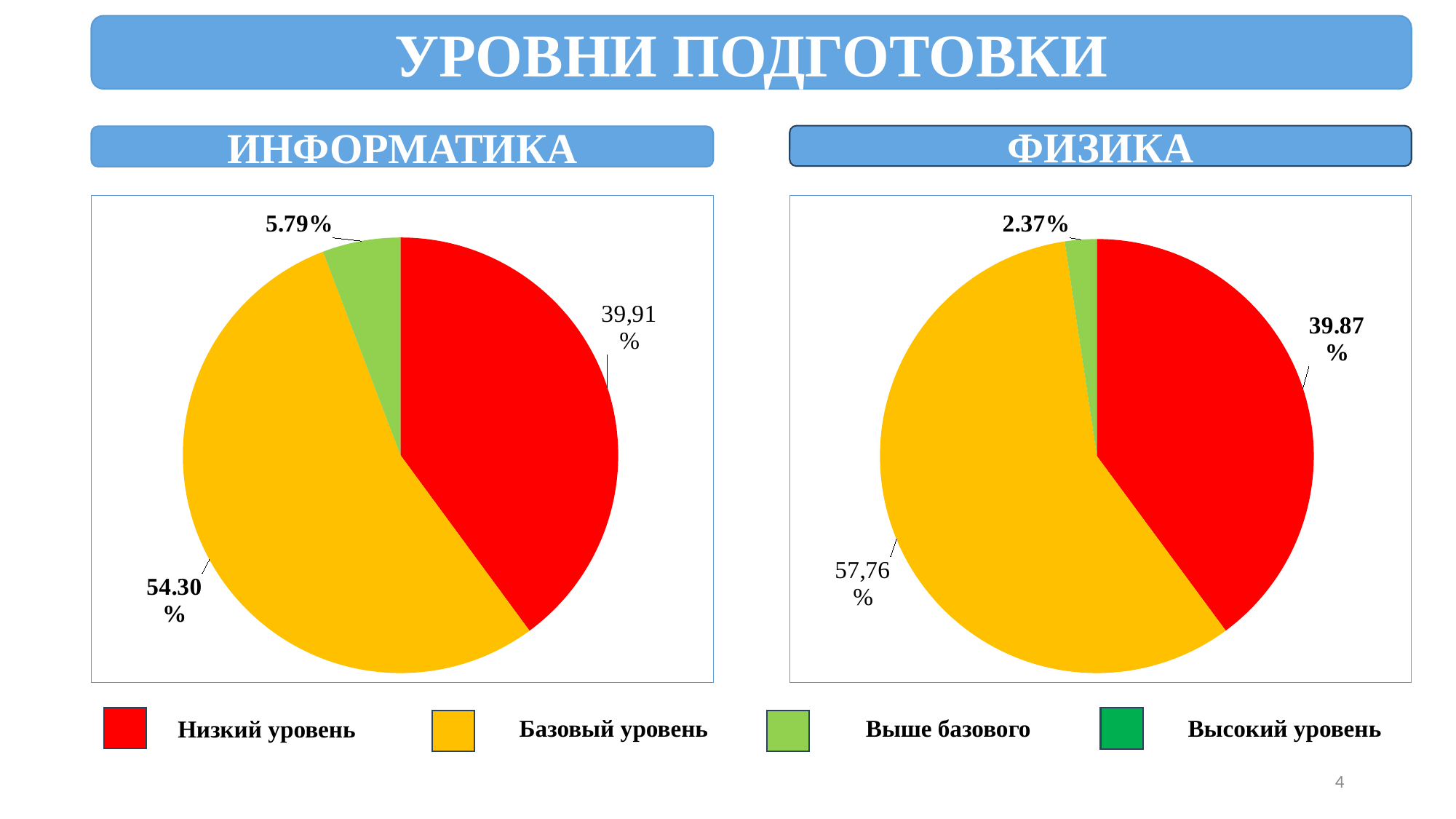
On the ФИЗИКА chart, what is the value for Низкий уровень? 39.87% How many categories does the shared legend list? 4 On the ФИЗИКА chart, what is the value for Выше базового? 2.37% On the ФИЗИКА chart, which category has the largest share? Базовый уровень What is the difference between the Выше базового share on the ИНФОРМАТИКА chart and on the ФИЗИКА chart? 3.42% Which chart has the larger share for Выше базового, ИНФОРМАТИКА or ФИЗИКА? ИНФОРМАТИКА On the ФИЗИКА chart, what is the value for Базовый уровень? 57,76% On the ИНФОРМАТИКА chart, what is the value for Низкий уровень? 39,91% On the ИНФОРМАТИКА chart, what is the value for Выше базового? 5.79% What kind of chart is used for ФИЗИКА? Pie chart On the ИНФОРМАТИКА chart, what is the value for Базовый уровень? 54.30%